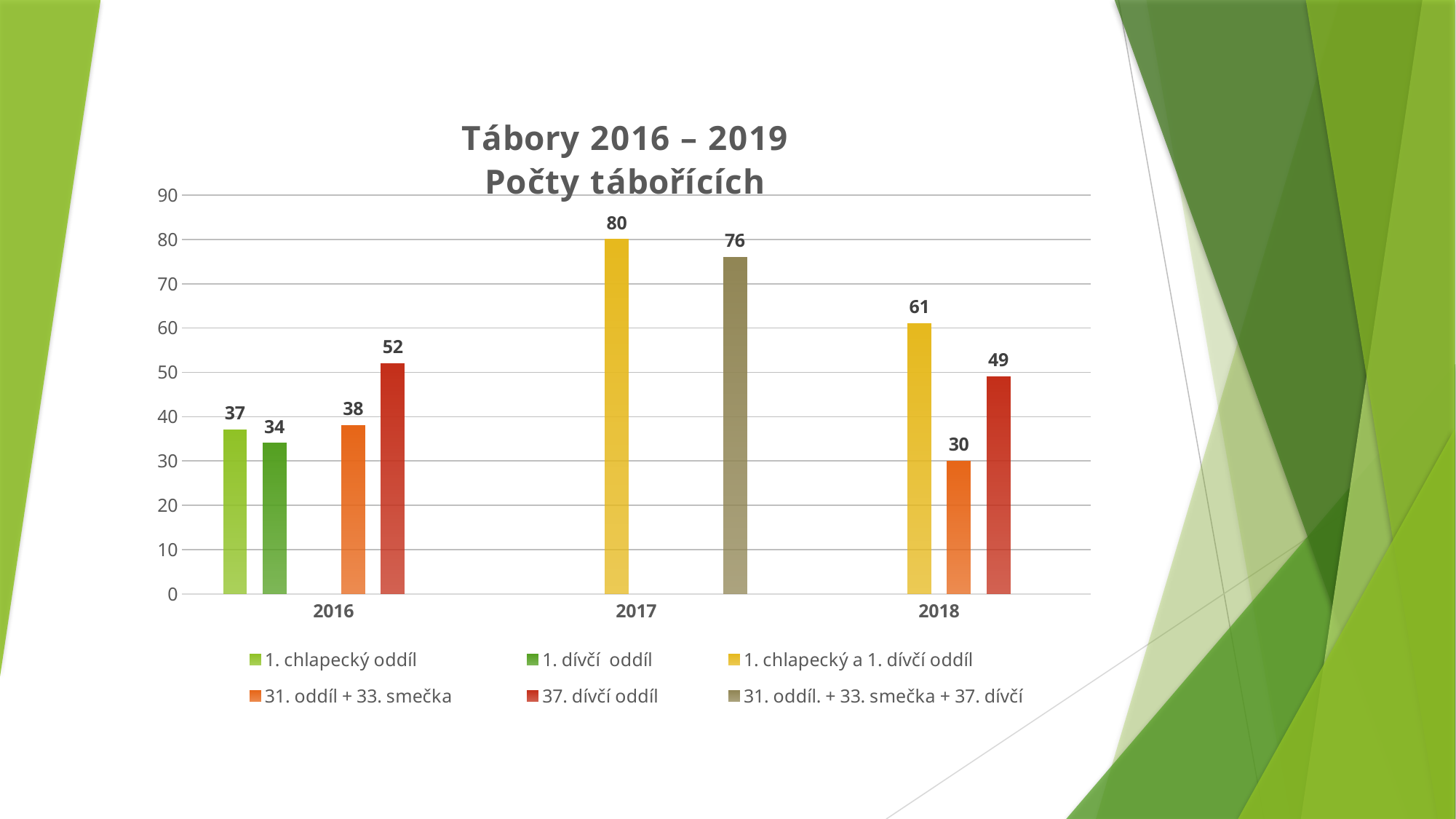
What kind of chart is shown on the slide? Bar chart How many year categories are shown on the x axis? 3 What is the value for "31. oddíl + 33. smečka" in 2018? 30 What is the value for "37. dívčí oddíl" in 2018? 49 What is the value for "1. chlapecký oddíl" in 2016? 37 How many series does the legend list? 6 Which is larger in 2016: "37. dívčí oddíl" or "31. oddíl + 33. smečka"? 37. dívčí oddíl What is the value for "1. chlapecký a 1. dívčí oddíl" in 2017? 80 Which bar has the highest value in the chart? 1. chlapecký a 1. dívčí oddíl in 2017 (80) Which bar has the lowest value in the chart? 31. oddíl + 33. smečka in 2018 (30) What is the title of the chart? Tábory 2016 – 2019 Počty tábořících What is the difference between the two bars shown for 2017? 4